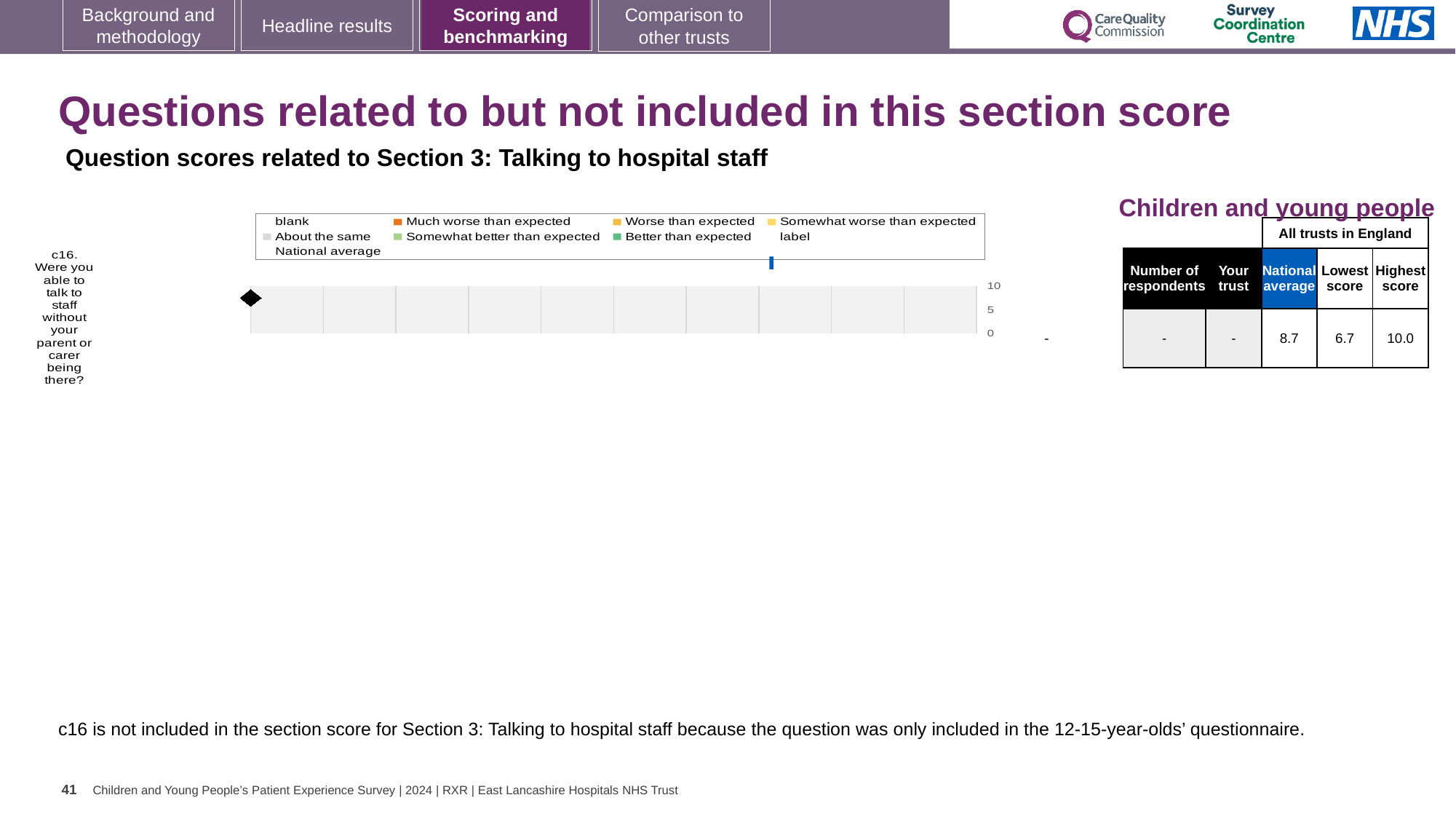
In the table next to the chart, what is the difference between the highest score and the lowest score for c16? 3.3 What is the highest tick value shown on the chart's value axis? 10 In the table next to the chart, what is the highest score across all trusts in England for c16? 10.0 In the table next to the chart, what is the national average score for c16? 8.7 How many question categories are plotted on the chart? 1 In the table next to the chart, what is shown for 'Your trust' for c16? - In the table next to the chart, what is the lowest score across all trusts in England for c16? 6.7 Which question is plotted on the chart? c16. Were you able to talk to staff without your parent or carer being there? In the table next to the chart, which is larger for c16: the national average or the lowest score? National average What kind of chart is shown for question c16? bar chart In the table next to the chart, is the national average for c16 greater or less than 5? greater